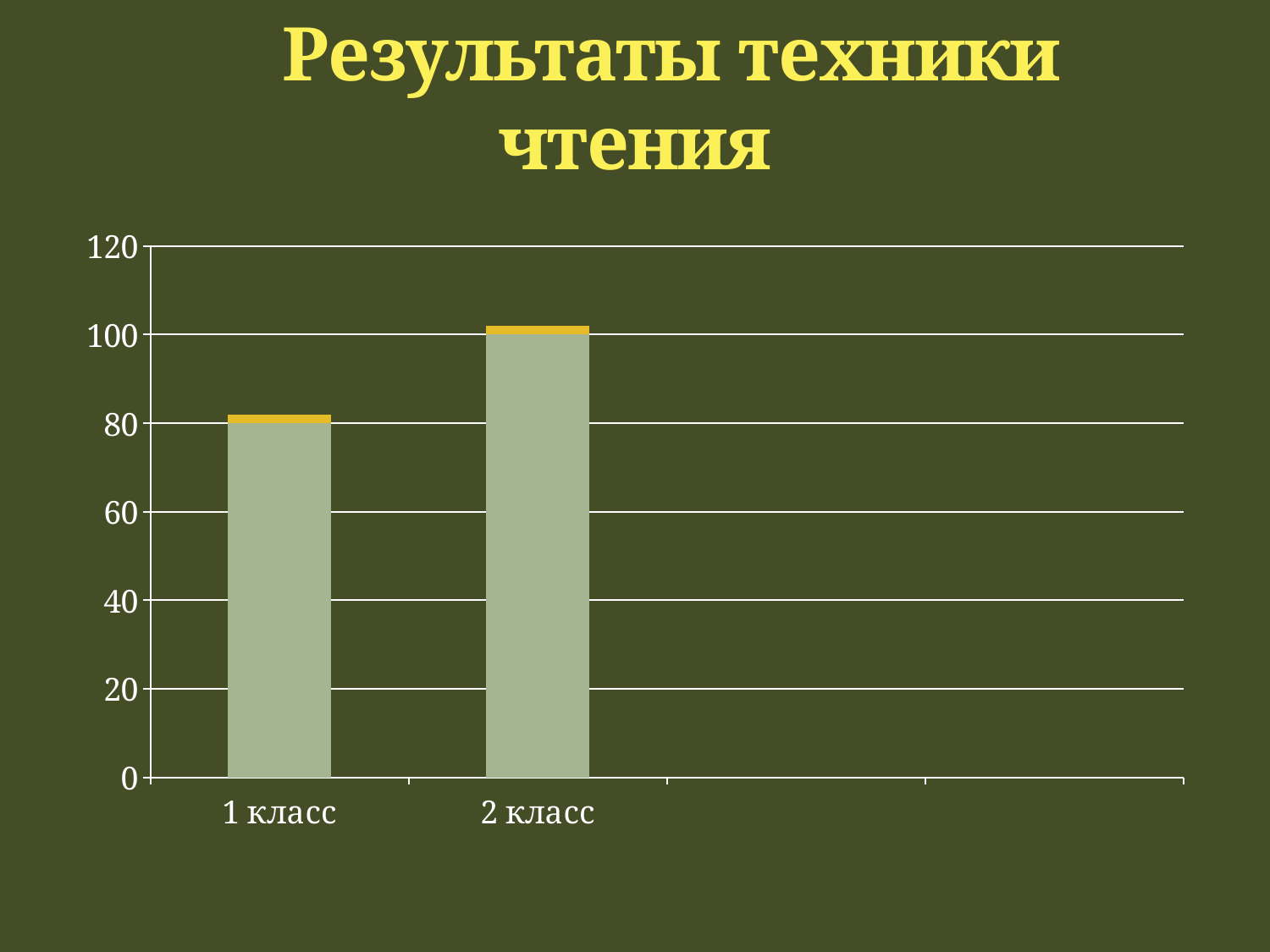
Do the values rise or fall from 1 класс to 2 класс? rise What is the title of the chart on the slide? Результаты техники чтения Is the value for 2 класс greater or less than 120? less Is the value for 1 класс greater or less than 60? greater What is the highest value shown on the vertical axis of the chart? 120 Is the value for 2 класс greater or less than 80? greater How many categories are plotted on the x axis of the chart? 2 Which category has the highest bar in the chart? 2 класс Which is larger, the value for 1 класс or the value for 2 класс? 2 класс Which category has the lowest bar in the chart? 1 класс What kind of chart is shown on the slide? bar chart